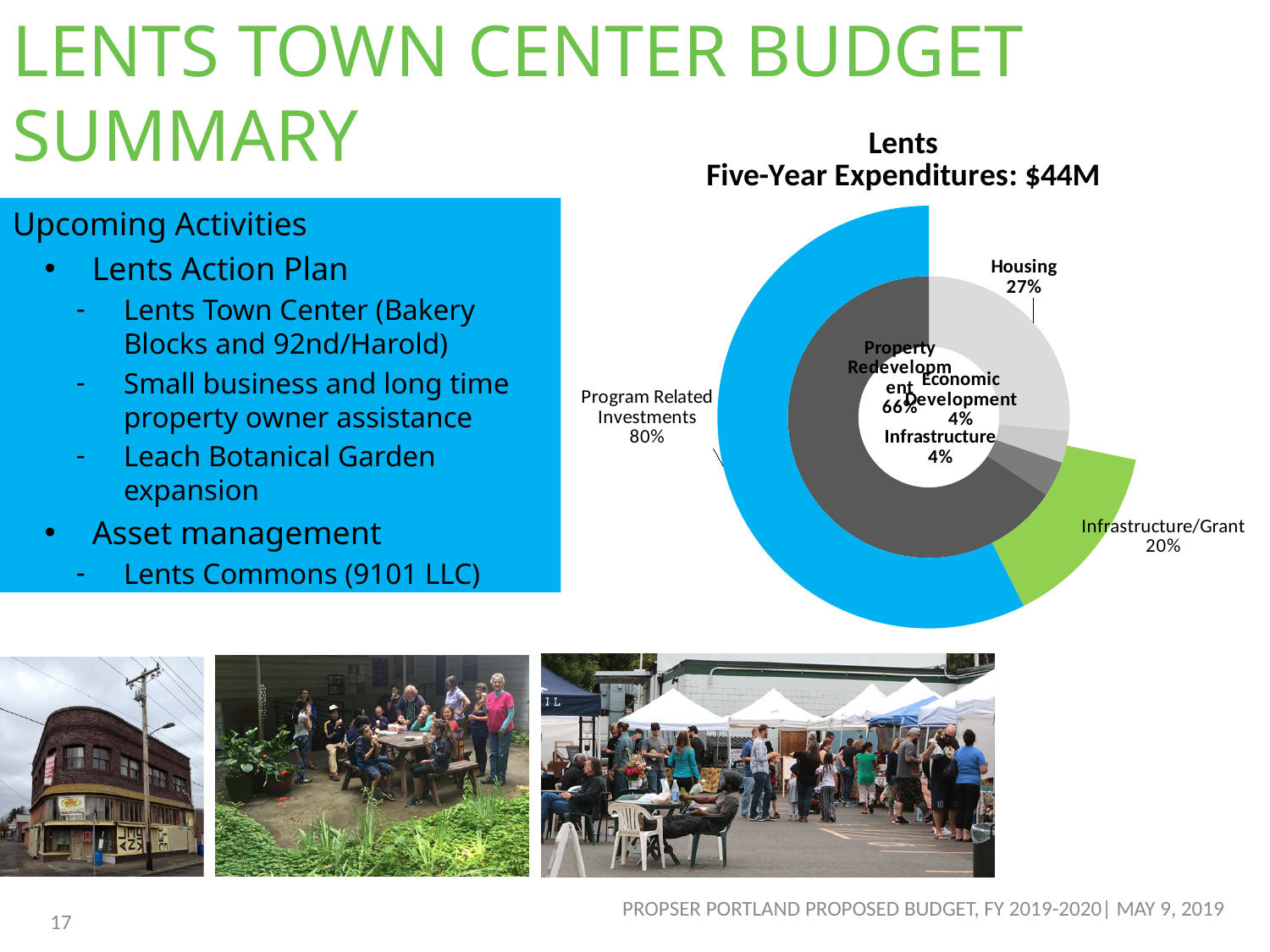
What percentage is shown for Economic Development? 4% What kind of chart is shown on the slide? doughnut chart Which category in the inner ring has the largest share? Property Redevelopment What is the difference in percentage points between Program Related Investments and Infrastructure/Grant? 60 What percentage is shown for Housing in the inner ring? 27% What is the title of the chart? Lents Five-Year Expenditures: $44M Which category in the outer ring has the smaller share? Infrastructure/Grant What share of the outer ring is Program Related Investments? 80% Which is larger, Housing or Property Redevelopment? Property Redevelopment What share of the outer ring is Infrastructure/Grant? 20% What percentage is shown for Property Redevelopment in the inner ring? 66% How many categories are labelled in the inner ring? 4